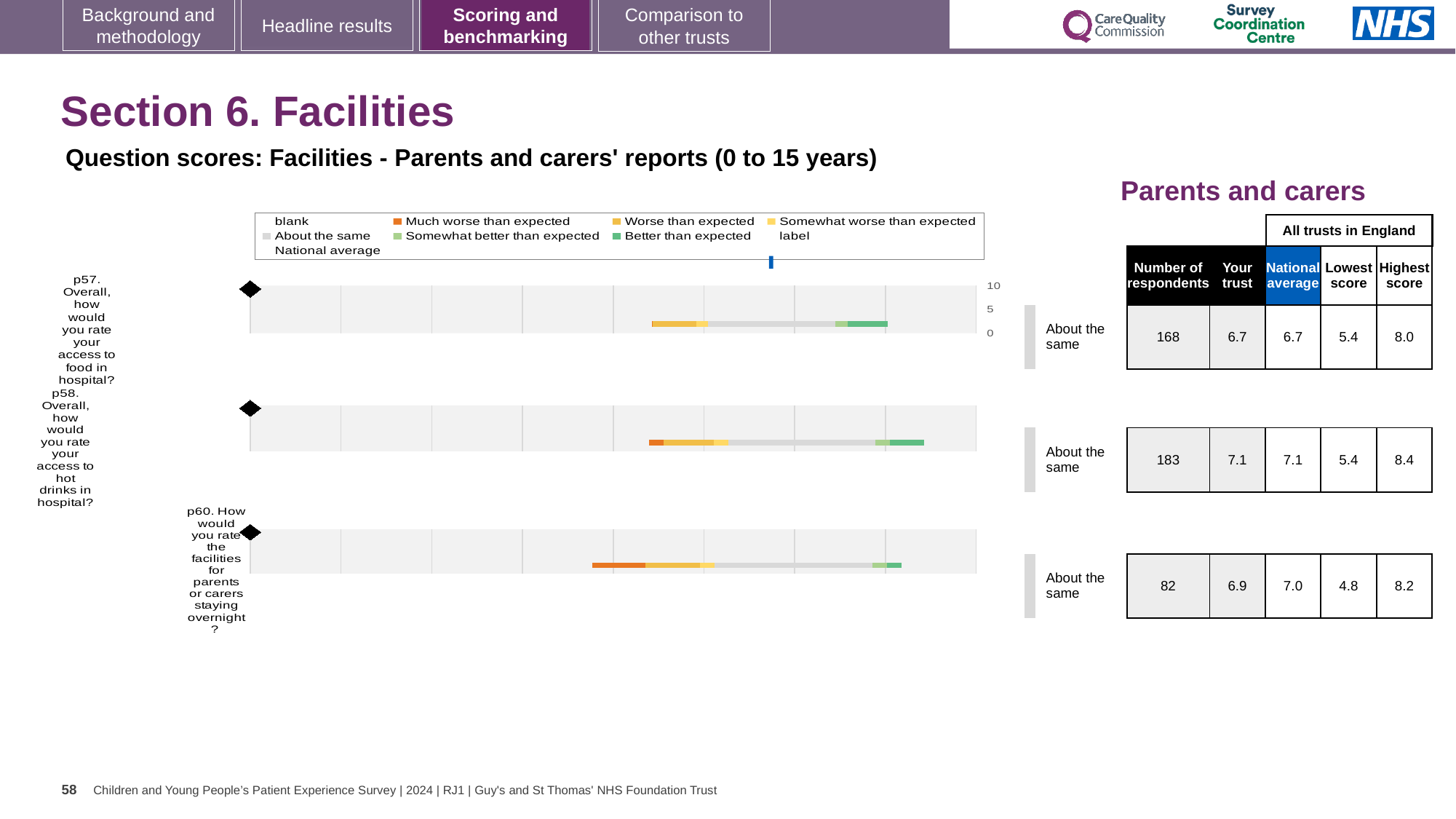
What kind of chart is used to show the benchmark bands for each question? Bar chart What is the highest score across all trusts in England shown for p58? 8.4 What is the 'Your trust' score shown for p57 (access to food in hospital)? 6.7 How many survey questions are plotted on the slide's charts? 3 What is the national average shown for p60 (facilities for parents or carers staying overnight)? 7.0 What is the number of respondents shown for p58 (access to hot drinks in hospital)? 183 For p60, which is larger: the 'Your trust' score or the national average? National average In the chart legend, what colour represents 'Much worse than expected'? Orange What is the difference between the highest score and the lowest score shown for p57? 2.6 What benchmark category label is shown next to each of the three charts? About the same Which of the three questions has the lowest 'Lowest score' across all trusts in England? p60 What is the highest tick value shown on the score axis of the charts? 10